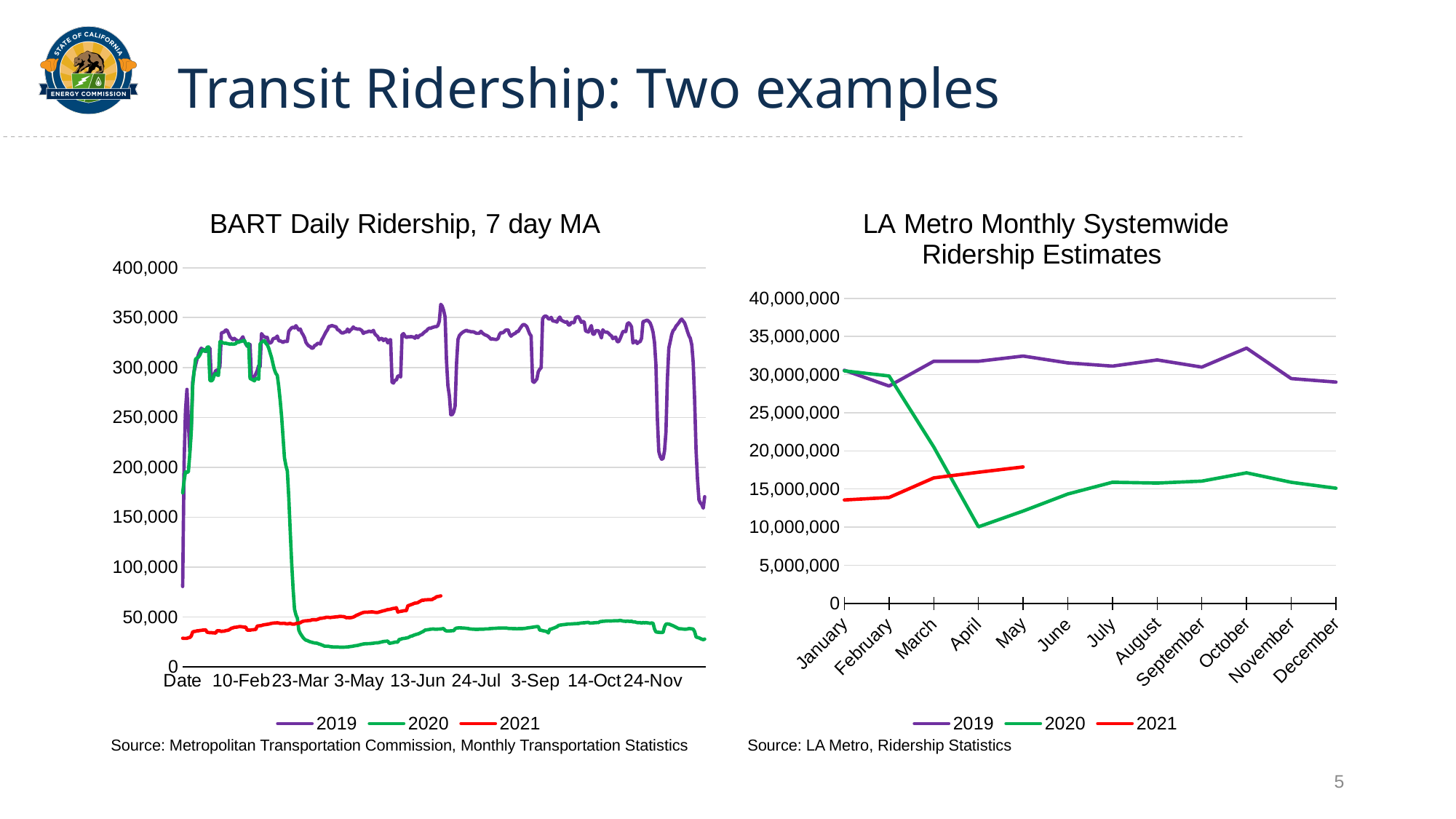
In the LA Metro Monthly Systemwide Ridership Estimates chart, which series has the larger value in July, 2019 or 2020? 2019 In the BART Daily Ridership, 7 day MA chart, is the 2020 value at 24-Jul greater or less than 100,000? less In the LA Metro Monthly Systemwide Ridership Estimates chart, is the 2020 value for April greater or less than 15,000,000? less In the LA Metro Monthly Systemwide Ridership Estimates chart, in which month is the 2020 value lowest? April How many months are shown on the x axis of the LA Metro Monthly Systemwide Ridership Estimates chart? 12 In the LA Metro Monthly Systemwide Ridership Estimates chart, is the 2019 value for January greater or less than 25,000,000? greater In the BART Daily Ridership, 7 day MA chart, which series is higher at 3-Sep, 2019 or 2020? 2019 In the LA Metro Monthly Systemwide Ridership Estimates chart, in which month is the 2019 value highest? October Which colour is used for the 2021 series in the BART Daily Ridership, 7 day MA chart? red How many series does the legend of the LA Metro Monthly Systemwide Ridership Estimates chart list? 3 What kind of chart is the BART Daily Ridership, 7 day MA chart? line chart In the LA Metro Monthly Systemwide Ridership Estimates chart, does the 2021 line rise or fall from January to May? rise